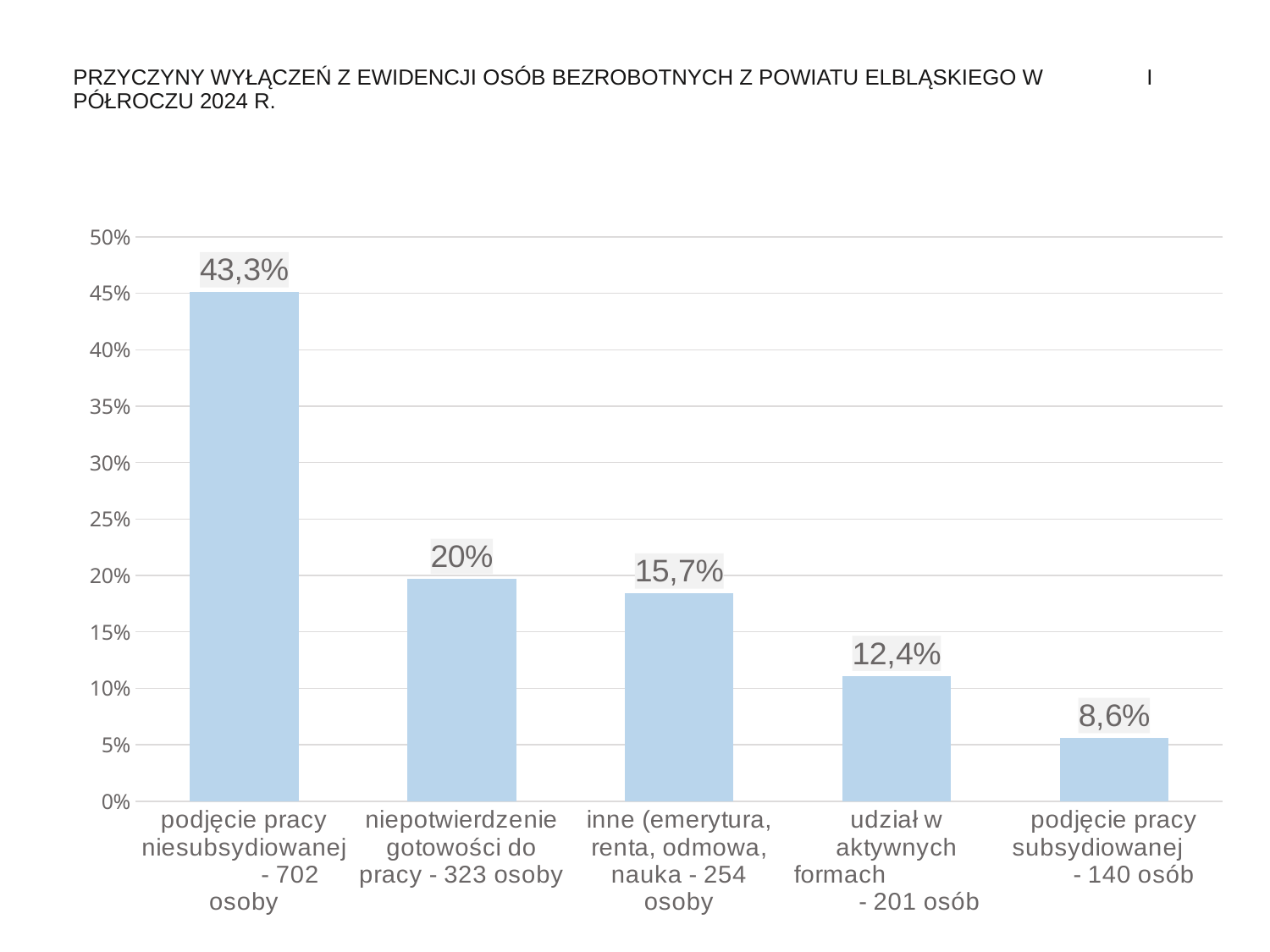
Which is larger: the percentage for 'inne (emerytura, renta, odmowa, nauka)' or for 'udział w aktywnych formach'? inne (emerytura, renta, odmowa, nauka) How many categories are shown in the chart? 5 What type of chart is shown on the slide? bar chart What is the difference in percentage points between 'podjęcie pracy niesubsydiowanej' and 'niepotwierdzenie gotowości do pracy'? 23,3 percentage points What percentage is shown for 'udział w aktywnych formach'? 12,4% What percentage is shown for 'niepotwierdzenie gotowości do pracy'? 20% Do the values rise or fall from left to right along the x axis? fall What percentage is shown for 'podjęcie pracy niesubsydiowanej'? 43,3% Which category has the highest percentage? podjęcie pracy niesubsydiowanej Which category has the lowest percentage? podjęcie pracy subsydiowanej What is the difference in percentage points between 'udział w aktywnych formach' and 'podjęcie pracy subsydiowanej'? 3,8 percentage points What percentage is shown for 'podjęcie pracy subsydiowanej'? 8,6%